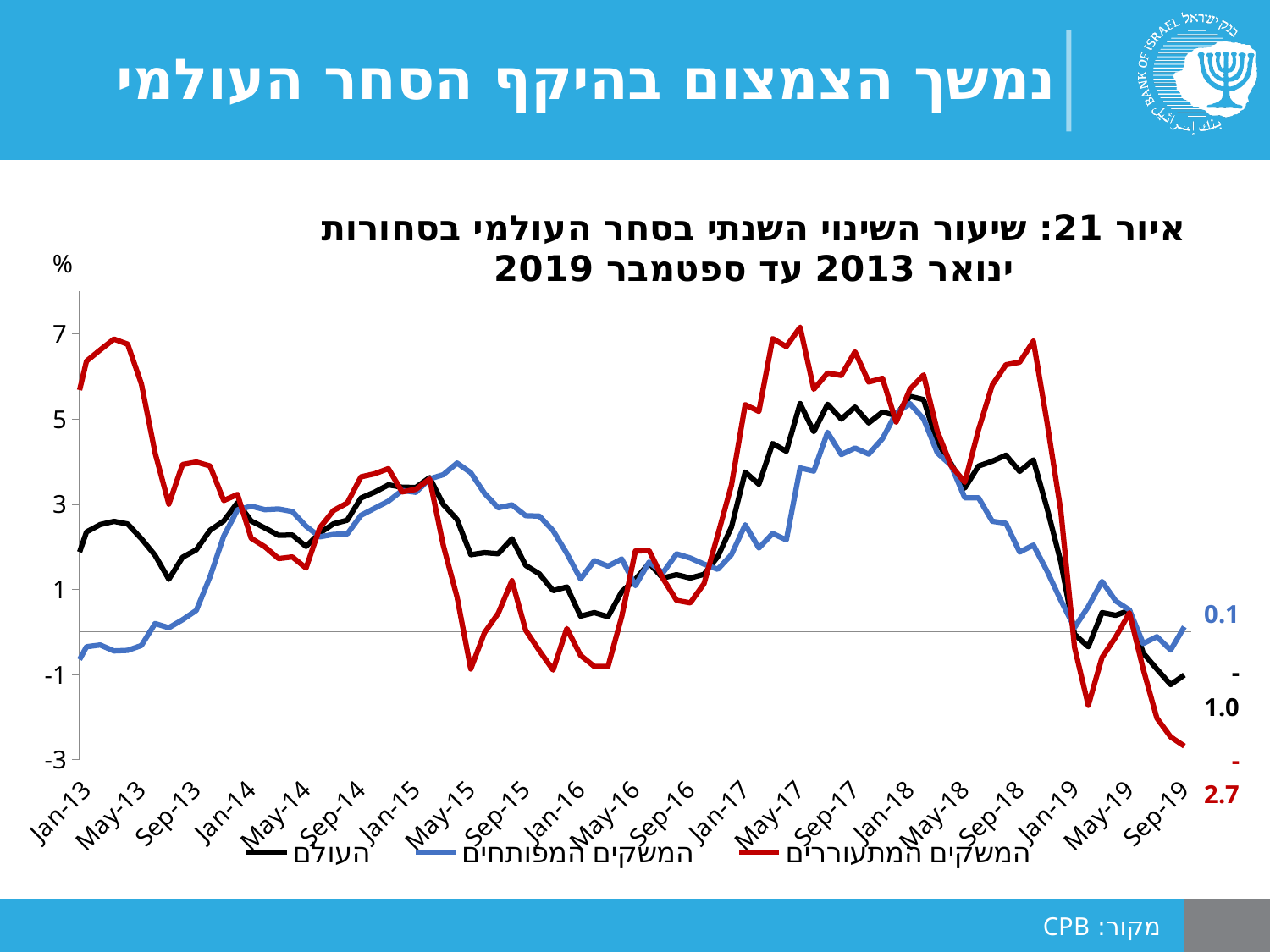
What kind of chart is shown on the slide? line chart Which series has the highest labelled value at the end of the chart? המשקים המפותחים What unit is shown on the vertical axis of the chart? % What is the final value labelled for the העולם (black) series at the end of the chart? -1.0 Does the המשקים המתעוררים (red) series rise or fall between Jan-19 and Sep-19? fall What is the difference between the final labelled values of המשקים המפותחים (0.1) and המשקים המתעוררים (-2.7)? 2.8 What is the final value labelled for the המשקים המתעוררים (red) series at the end of the chart? -2.7 Which series has the lowest labelled value at the end of the chart? המשקים המתעוררים What is the final value labelled for the המשקים המפותחים (blue) series at the end of the chart? 0.1 Is the value of the העולם (black) series at Jan-18 greater or less than 3? greater At the end of the chart, which is larger: the labelled value for העולם or for המשקים המתעוררים? העולם How many series does the legend list? 3